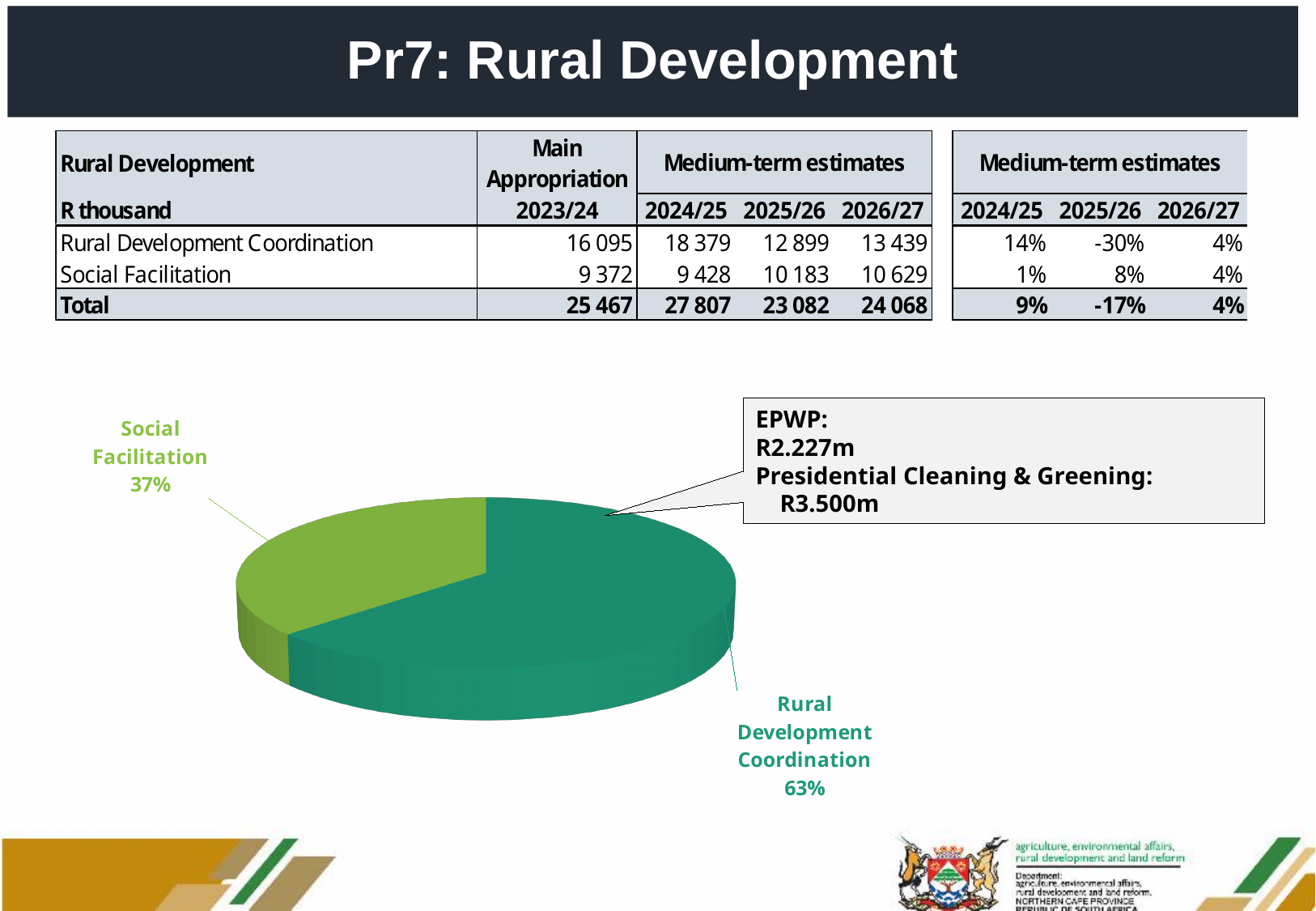
By how many percentage points does the Rural Development Coordination slice exceed the Social Facilitation slice? 26 percentage points Which slice of the pie chart is the largest? Rural Development Coordination Is the share for Social Facilitation greater or less than 50%? less Which is larger in the pie chart, Social Facilitation or Rural Development Coordination? Rural Development Coordination What colour is the Social Facilitation slice of the pie chart? Light green What share of the pie chart does Rural Development Coordination represent? 63% Which slice of the pie chart is the smallest? Social Facilitation What share of the pie chart does Social Facilitation represent? 37% What EPWP amount is shown in the callout box next to the pie chart? R2.227m What kind of chart is shown on the slide? Pie chart How many slices does the pie chart have? 2